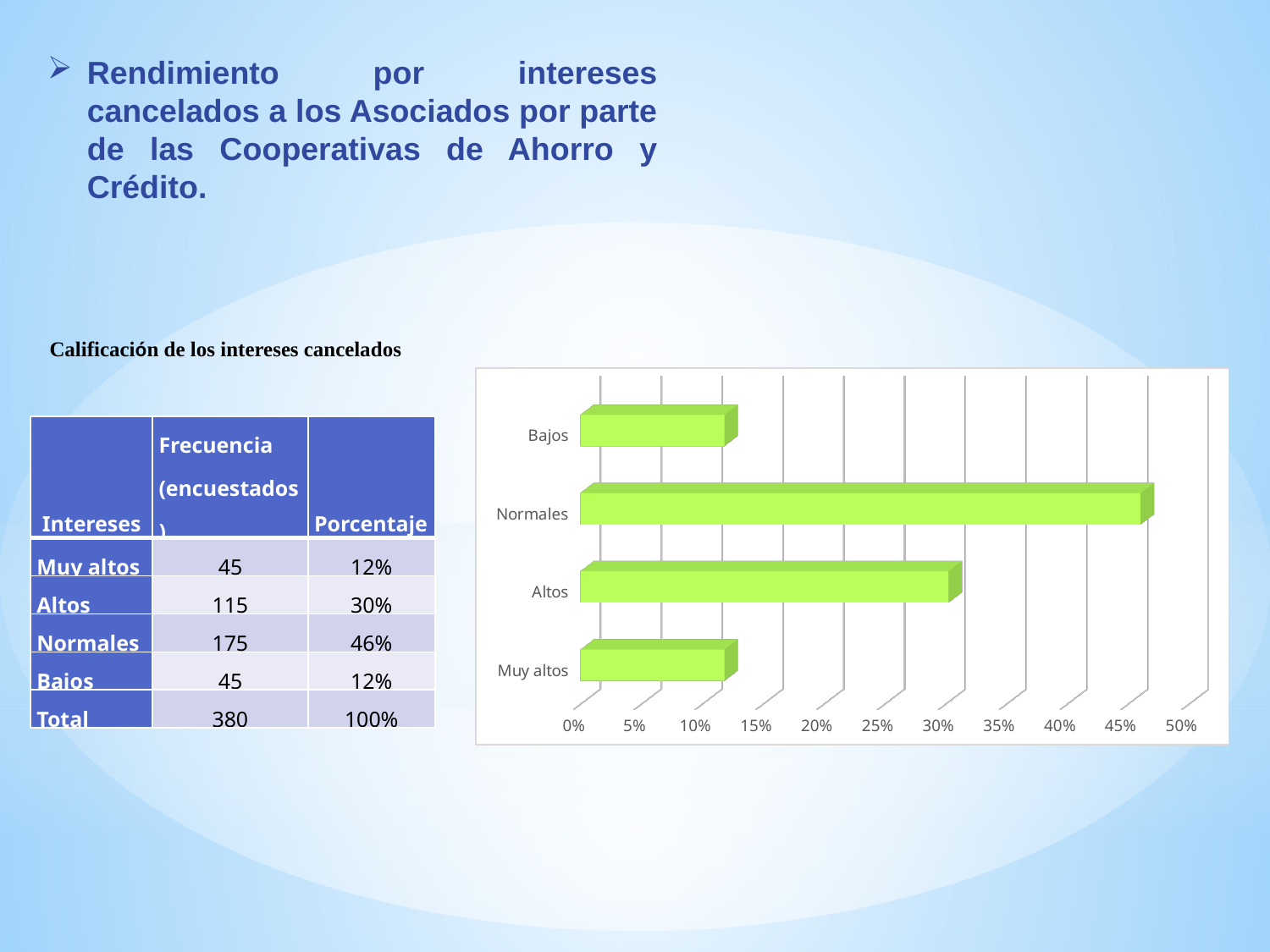
What kind of chart is shown on the slide? bar chart Which category has the highest value in the bar chart? Normales What is the highest value shown on the horizontal axis of the bar chart? 50% Is the value for Normales in the bar chart greater or less than 40%? greater According to the table accompanying the chart, what percentage corresponds to Normales? 46% Which is larger in the bar chart, the value for Normales or the value for Altos? Normales According to the table accompanying the chart, what percentage corresponds to Altos? 30% Is the value for Muy altos in the bar chart greater or less than 20%? less How many categories does the bar chart show? 4 Is the value for Altos in the bar chart greater or less than 25%? greater Which is larger in the bar chart, the value for Altos or the value for Bajos? Altos